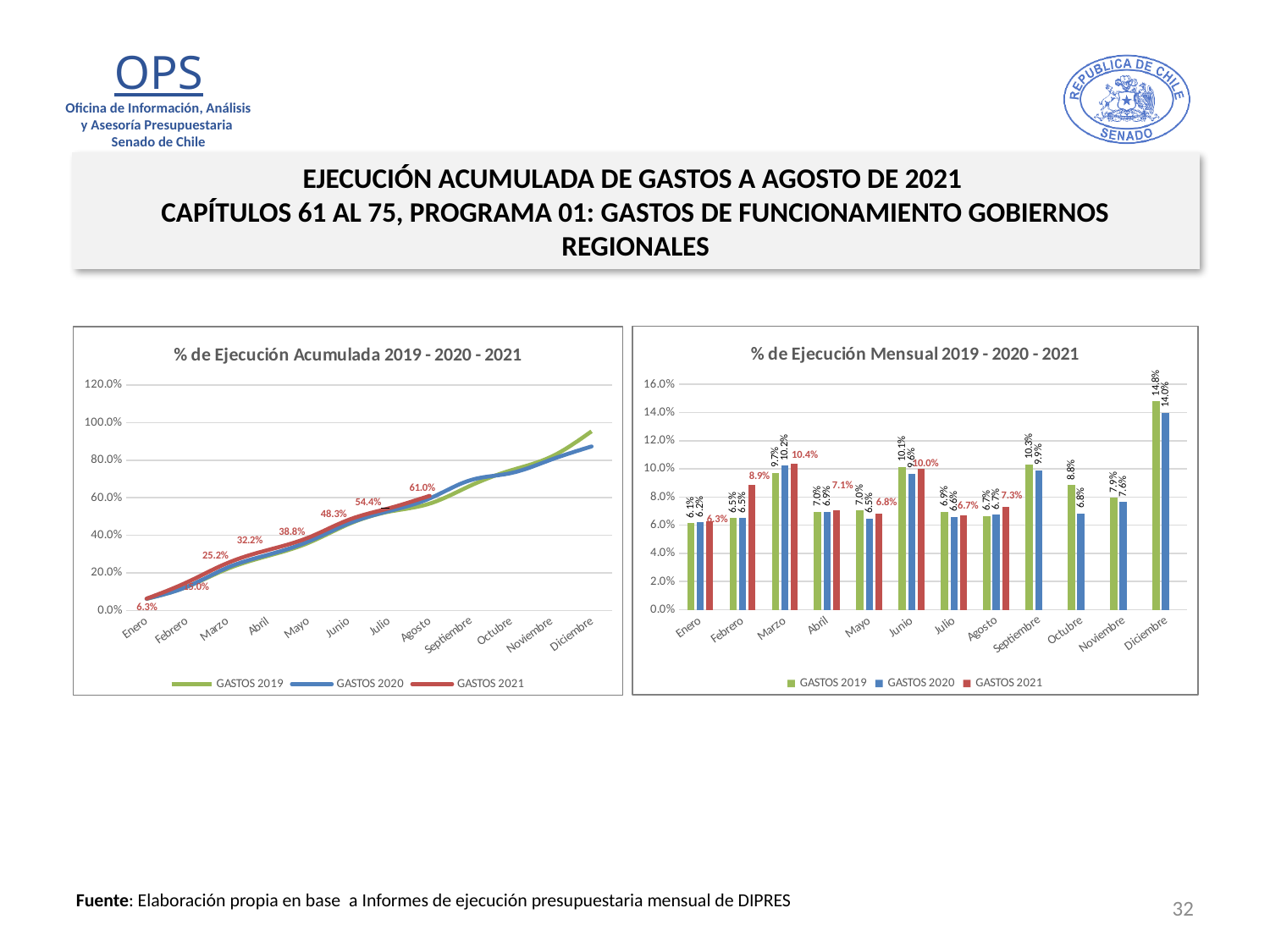
In the left chart (% de Ejecución Acumulada 2019 - 2020 - 2021), what is the value for GASTOS 2021 in Marzo? 25.2% In the right chart (% de Ejecución Mensual 2019 - 2020 - 2021), what is the value for GASTOS 2021 in Febrero? 8.9% In the right chart (% de Ejecución Mensual 2019 - 2020 - 2021), which month has the highest value for GASTOS 2020? Diciembre In the right chart (% de Ejecución Mensual 2019 - 2020 - 2021), which is larger in Marzo: GASTOS 2019 or GASTOS 2021? GASTOS 2021 In the left chart (% de Ejecución Acumulada 2019 - 2020 - 2021), what is the difference between the GASTOS 2021 values for Julio and Junio? 6.1% In the left chart (% de Ejecución Acumulada 2019 - 2020 - 2021), do the GASTOS 2021 values rise or fall from Enero to Agosto? rise In the left chart (% de Ejecución Acumulada 2019 - 2020 - 2021), what is the value for GASTOS 2021 in Agosto? 61.0% What kind of chart is the left chart (% de Ejecución Acumulada 2019 - 2020 - 2021)? line chart How many months are shown on the x axis of the right chart (% de Ejecución Mensual 2019 - 2020 - 2021)? 12 How many series does the legend of the right chart (% de Ejecución Mensual 2019 - 2020 - 2021) list? 3 In the right chart (% de Ejecución Mensual 2019 - 2020 - 2021), what is the value for GASTOS 2019 in Diciembre? 14.8% In the right chart (% de Ejecución Mensual 2019 - 2020 - 2021), what is the difference between GASTOS 2019 and GASTOS 2020 in Octubre? 2.0%